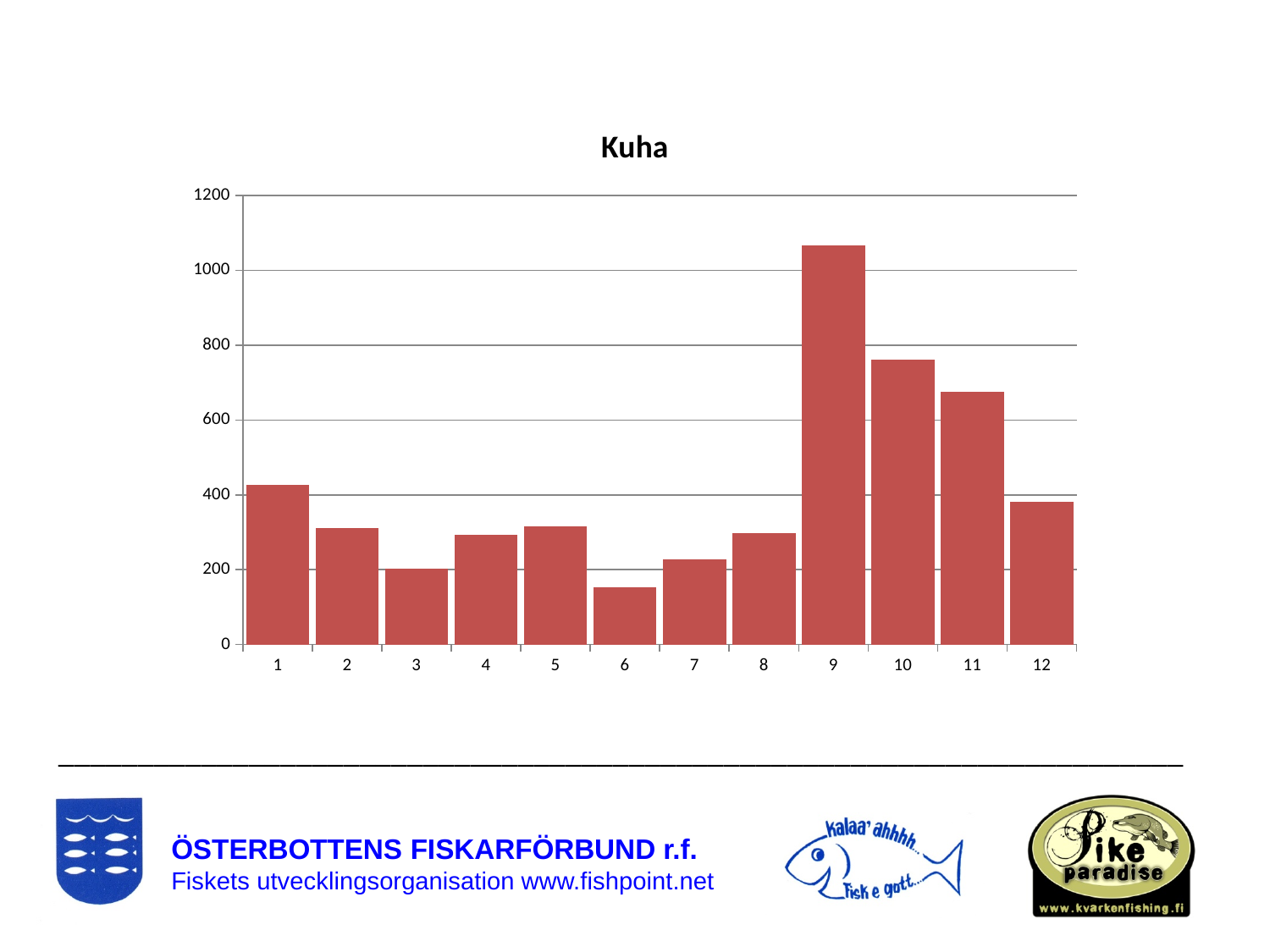
Which category has the highest value in the chart? 9 Is the value for category 1 greater or less than 400? greater Is the value for category 10 greater or less than 800? less Is the value for category 6 greater or less than 200? less What is the title of the chart? Kuha Which has the larger value, category 10 or category 11? 10 How many categories are shown on the x axis of the chart? 12 What kind of chart is shown on the slide? bar chart Which has the larger value, category 1 or category 2? 1 Which category has the lowest value in the chart? 6